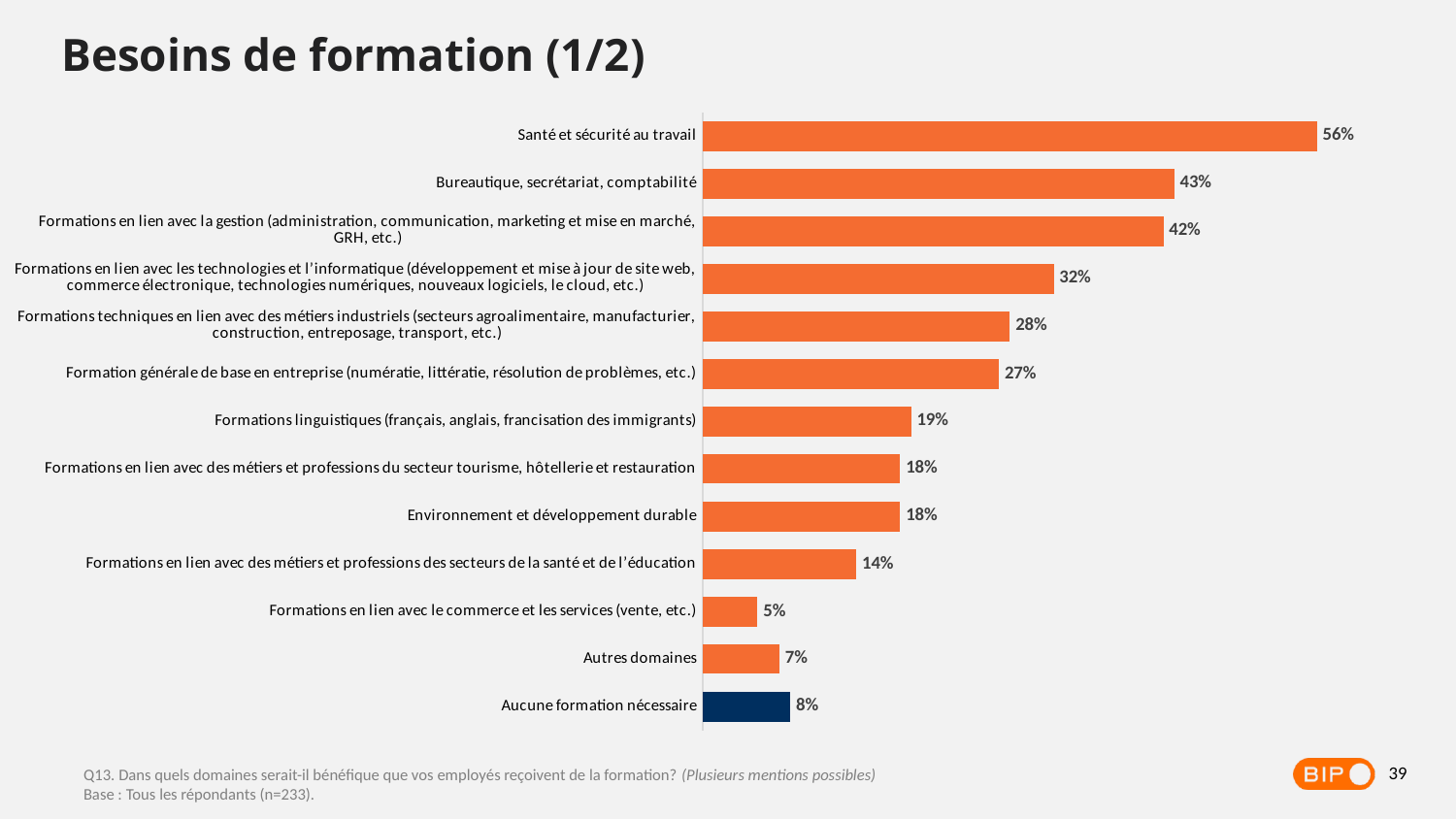
What kind of chart is shown on the slide? Bar chart What is the value for "Santé et sécurité au travail"? 56% What is the value for "Formations en lien avec des métiers et professions des secteurs de la santé et de l'éducation"? 14% Which is larger: "Autres domaines" or "Formations en lien avec le commerce et les services (vente, etc.)"? Autres domaines What is the value for "Aucune formation nécessaire"? 8% What is the difference between "Bureautique, secrétariat, comptabilité" and "Formations linguistiques (français, anglais, francisation des immigrants)"? 24% What is the title of the slide? Besoins de formation (1/2) Which category has the highest value? Santé et sécurité au travail Which bar is shown in a different colour (dark blue) from the others? Aucune formation nécessaire What is the value for "Environnement et développement durable"? 18% Which category has the lowest value? Formations en lien avec le commerce et les services (vente, etc.) How many categories are shown in the chart? 13